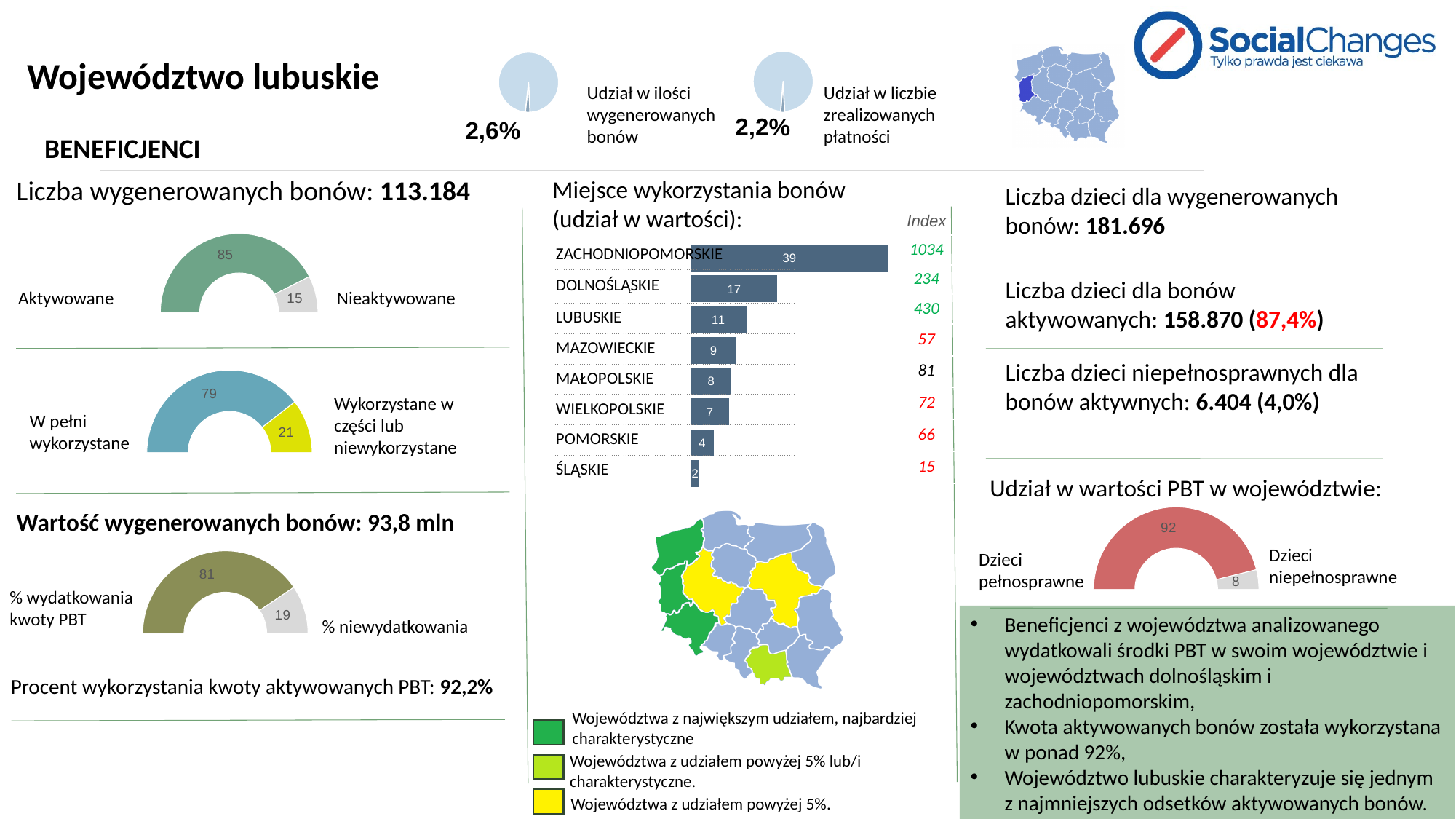
What type of chart is 'Miejsce wykorzystania bonów (udział w wartości)'? bar chart In the bar chart 'Miejsce wykorzystania bonów (udział w wartości)', which voivodeship has the lowest value? ŚLĄSKIE In the bar chart 'Miejsce wykorzystania bonów (udział w wartości)', which is larger: MAZOWIECKIE or POMORSKIE? MAZOWIECKIE In the bar chart 'Miejsce wykorzystania bonów (udział w wartości)', what is the difference between the values for ZACHODNIOPOMORSKIE and DOLNOŚLĄSKIE? 22 In the bar chart 'Miejsce wykorzystania bonów (udział w wartości)', what is the value for LUBUSKIE? 11 In the bar chart 'Miejsce wykorzystania bonów (udział w wartości)', do the values rise or fall going down the list from ZACHODNIOPOMORSKIE to ŚLĄSKIE? fall In the bar chart 'Miejsce wykorzystania bonów (udział w wartości)', which voivodeship has the highest value? ZACHODNIOPOMORSKIE How many voivodeships are listed in the bar chart 'Miejsce wykorzystania bonów (udział w wartości)'? 8 In the half-donut chart 'Udział w wartości PBT w województwie', what is the value for 'Dzieci pełnosprawne'? 92 In the half-donut chart showing 'W pełni wykorzystane', what is the value for 'Wykorzystane w części lub niewykorzystane'? 21 In the half-donut chart under 'Liczba wygenerowanych bonów', what is the value for Aktywowane? 85 In the half-donut chart under 'Wartość wygenerowanych bonów', what is the value for '% niewydatkowania'? 19